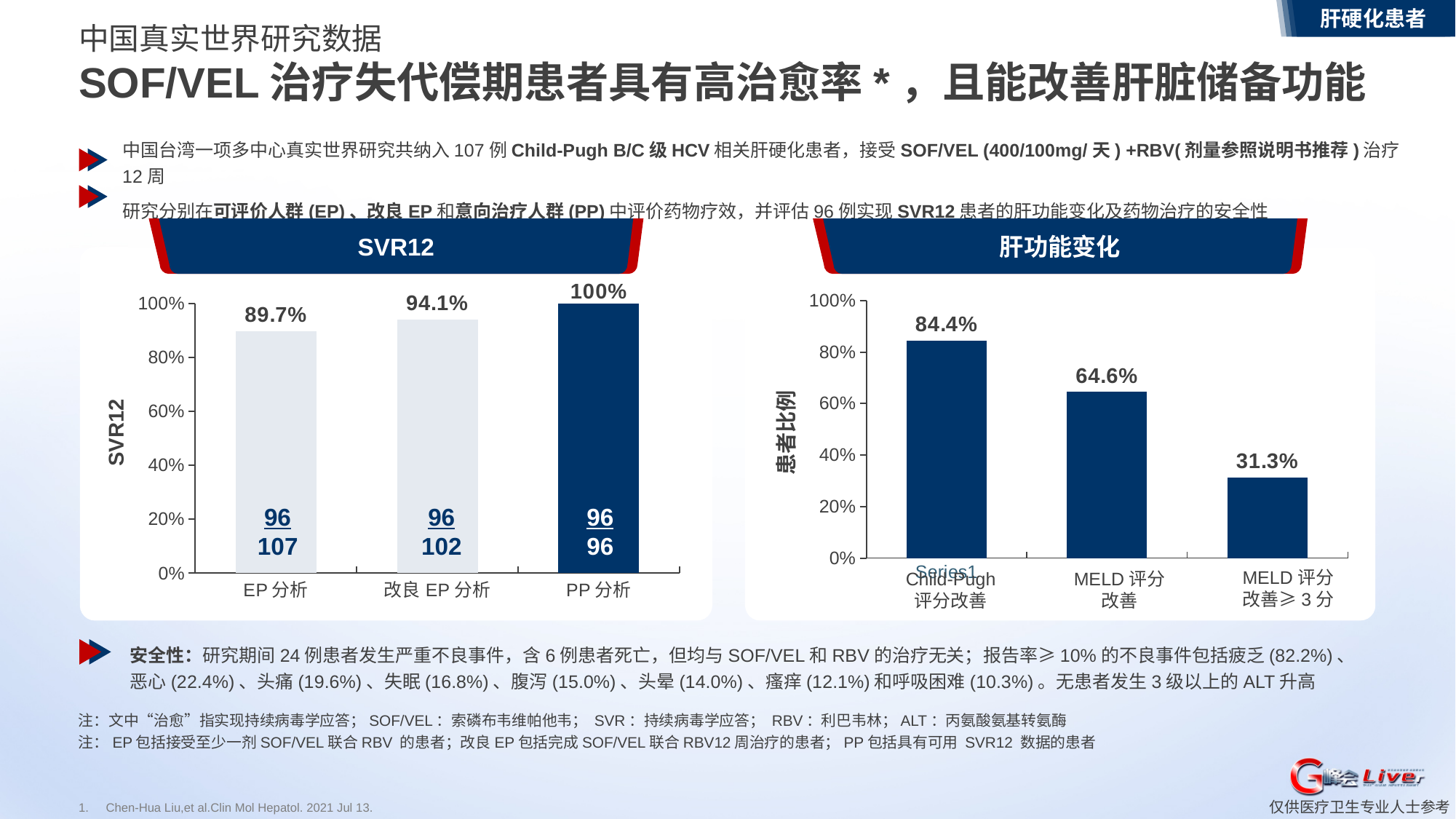
In the SVR12 chart, what is the SVR12 value for 改良 EP 分析? 94.1% In the SVR12 chart, what is the SVR12 value for PP 分析? 100% In the 肝功能变化 chart, what is the difference between Child-Pugh 评分改善 and MELD 评分改善? 19.8% In the SVR12 chart, do the values rise or fall from EP 分析 to PP 分析? rise In the 肝功能变化 chart, which category has the highest value? Child-Pugh 评分改善 In the SVR12 chart, how many analysis groups are shown? 3 In the SVR12 chart, what is the difference between the SVR12 for PP 分析 and EP 分析? 10.3% In the 肝功能变化 chart, what percentage of patients had Child-Pugh 评分改善? 84.4% In the 肝功能变化 chart, is the value for MELD 评分改善 greater or less than 60%? greater In the 肝功能变化 chart, what percentage of patients had MELD 评分改善≥3分? 31.3% In the SVR12 chart, which analysis group has the lowest SVR12? EP 分析 What type of chart is the 肝功能变化 chart? bar chart